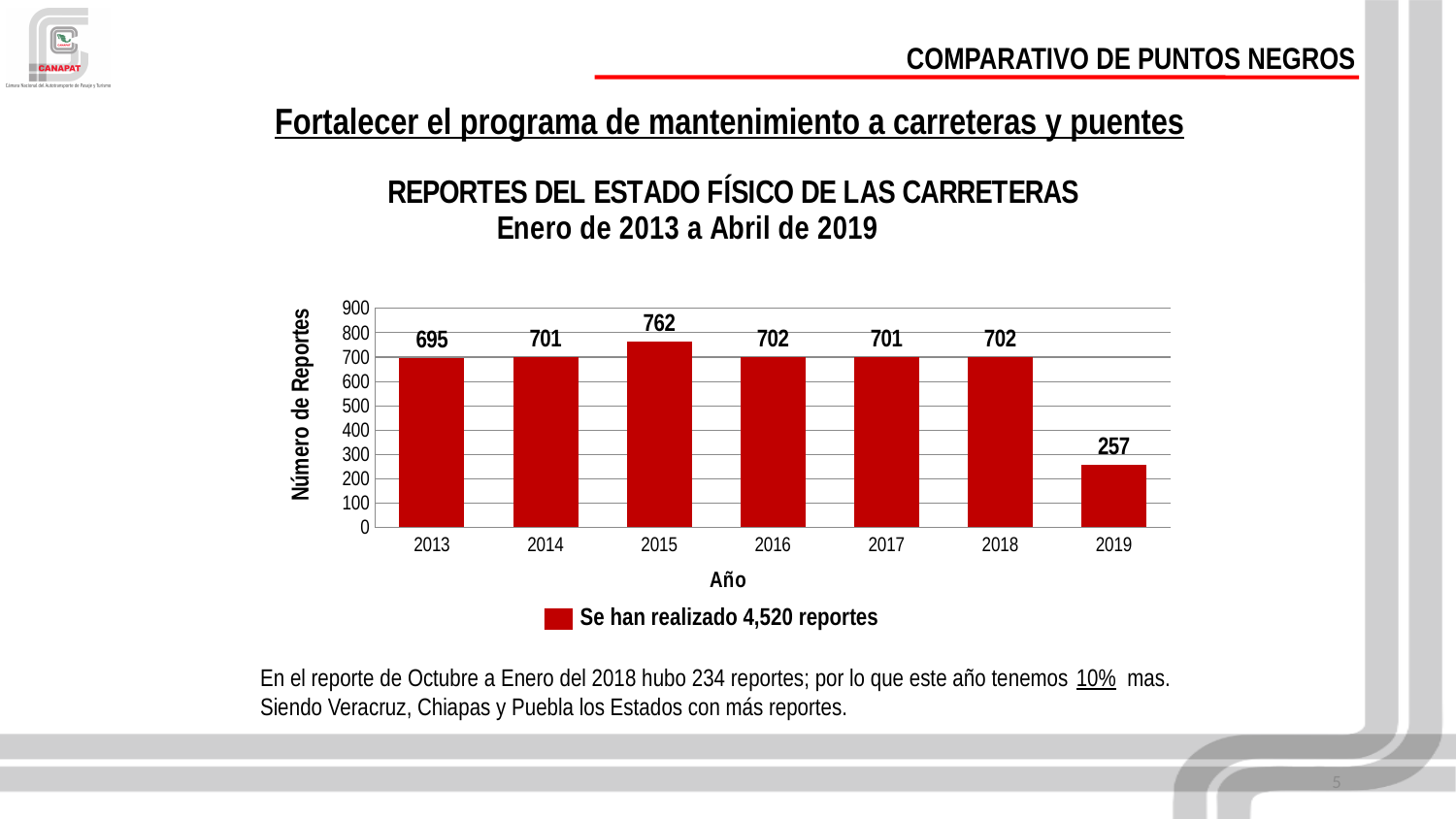
Is the value for 2019 greater or less than 300? less What is the label of the y axis? Número de Reportes Which year has the highest number of reports? 2015 Which year has more reports, 2015 or 2013? 2015 What kind of chart is shown on the slide? bar chart What is the number of reports for 2013? 695 How many years are shown on the x axis? 7 What is the difference between the number of reports in 2015 and 2019? 505 What is the number of reports for 2015? 762 What is the difference between the number of reports in 2014 and 2013? 6 Which year has the lowest number of reports? 2019 What is the number of reports for 2019? 257